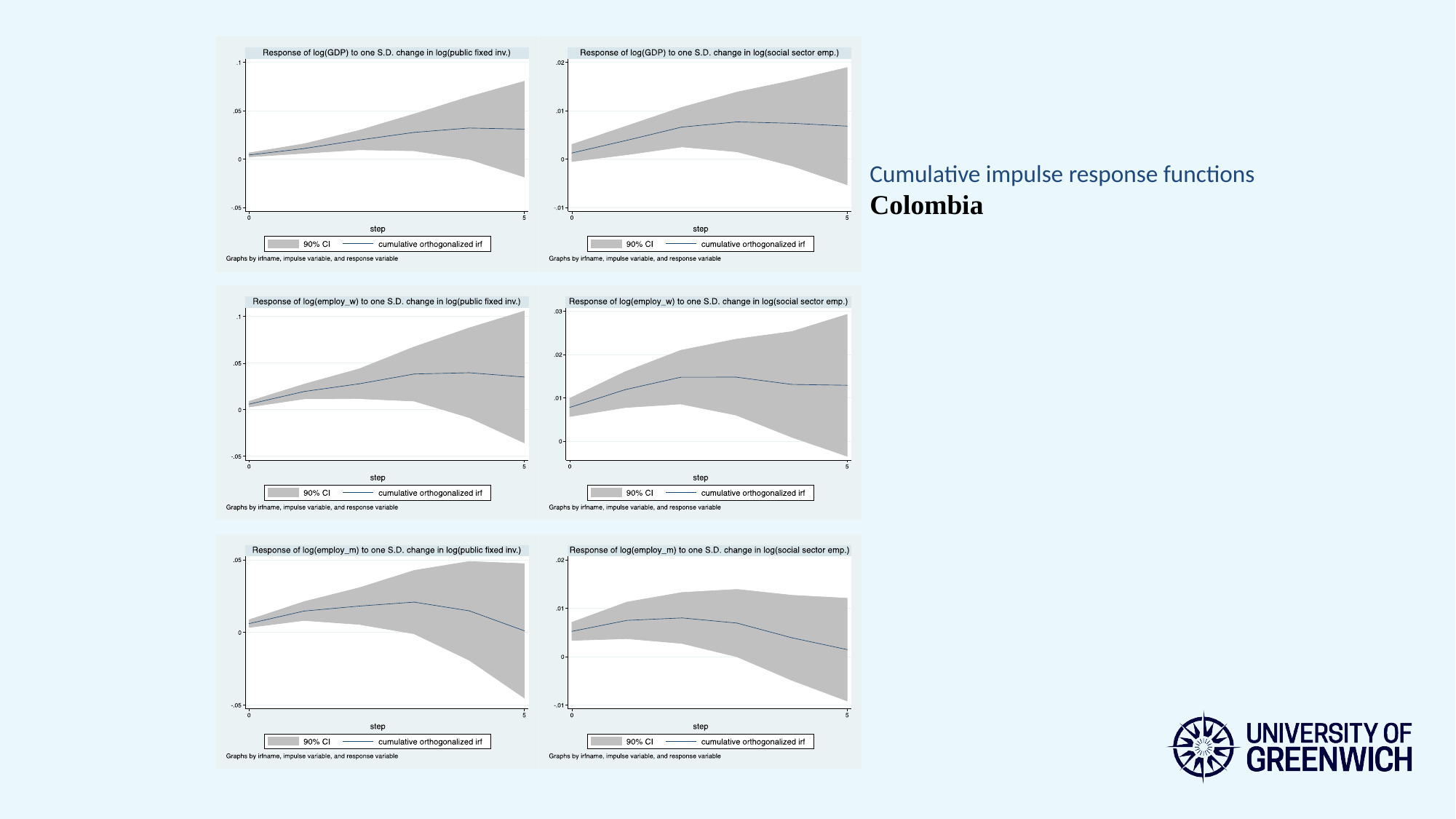
In the bottom-right chart, 'Response of log(employ_m) to one S.D. change in log(social sector emp.)', is the cumulative orthogonalized irf value at step 5 greater or less than .01? less In the middle-right chart, 'Response of log(employ_w) to one S.D. change in log(social sector emp.)', is the cumulative orthogonalized irf value at step 5 greater or less than .01? greater How many charts are shown on the slide? 6 In the middle-right chart, 'Response of log(employ_w) to one S.D. change in log(social sector emp.)', is the cumulative orthogonalized irf value at step 5 greater or less than .02? less In the bottom-left chart, 'Response of log(employ_m) to one S.D. change in log(public fixed inv.)', does the cumulative orthogonalized irf line rise or fall between step 3 and step 5? fall What is the x-axis label on the middle-left chart, 'Response of log(employ_w) to one S.D. change in log(public fixed inv.)'? step What kind of chart is the top-left chart, 'Response of log(GDP) to one S.D. change in log(public fixed inv.)'? line chart How many entries does the legend of the top-left chart list? 2 In the top-left chart, 'Response of log(GDP) to one S.D. change in log(public fixed inv.)', does the cumulative orthogonalized irf line rise or fall from step 0 to step 5? rise What are the two legend entries shown under the bottom-right chart? 90% CI and cumulative orthogonalized irf